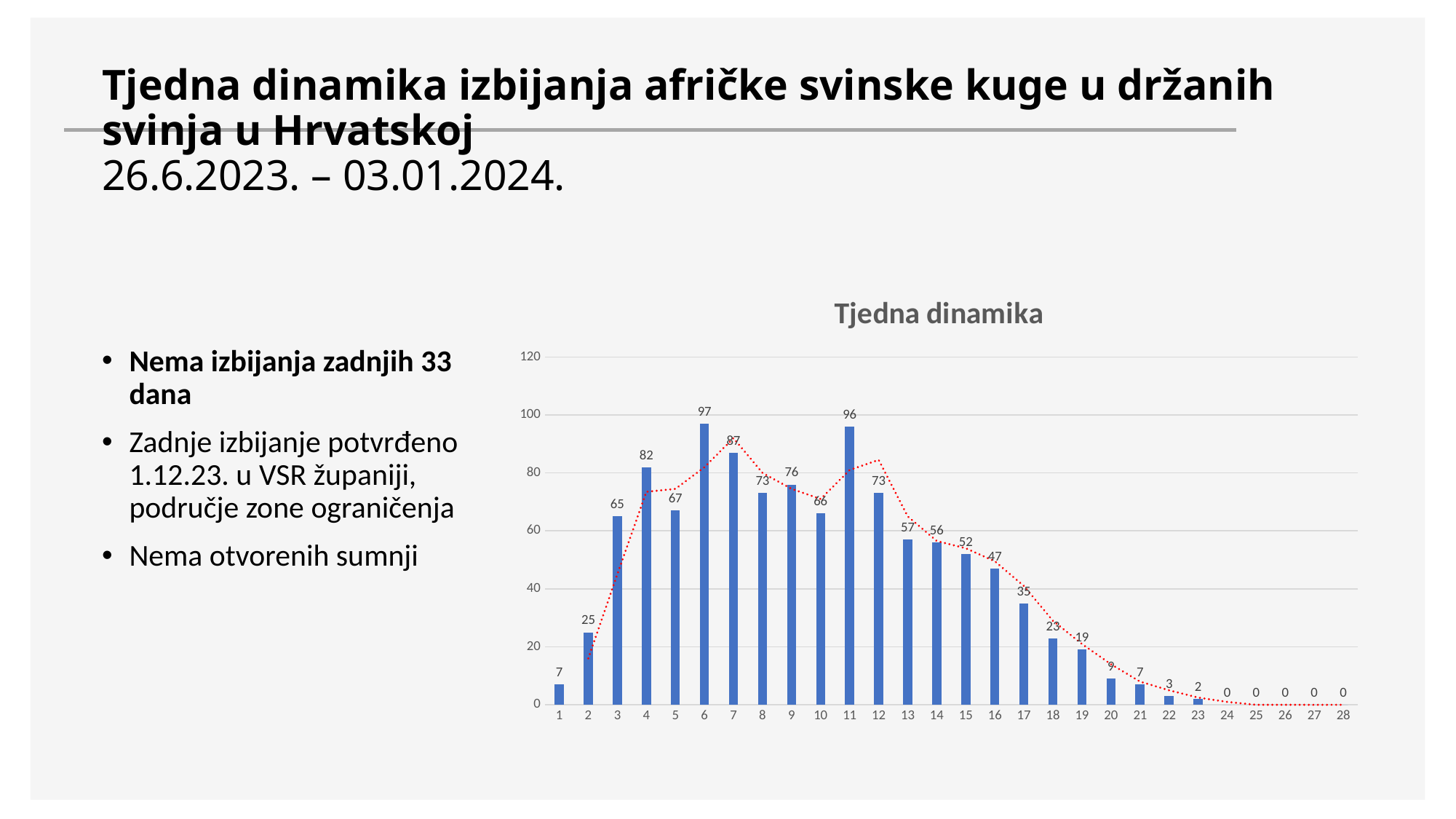
What is the value for week 17 in the Tjedna dinamika chart? 35 What kind of chart is the Tjedna dinamika chart? bar chart What is the difference between the values for week 4 and week 5 in the Tjedna dinamika chart? 15 What is the value for week 6 in the Tjedna dinamika chart? 97 What is the value for week 11 in the Tjedna dinamika chart? 96 What is the difference between the values for week 6 and week 11 in the Tjedna dinamika chart? 1 Is the value for week 13 in the Tjedna dinamika chart greater or less than 60? less How many weeks are shown on the x axis of the Tjedna dinamika chart? 28 What is the value for week 2 in the Tjedna dinamika chart? 25 Do the values in the Tjedna dinamika chart rise or fall from week 12 to week 28? fall Which is larger in the Tjedna dinamika chart, the value for week 9 or the value for week 10? week 9 Which week has the highest value in the Tjedna dinamika chart? 6